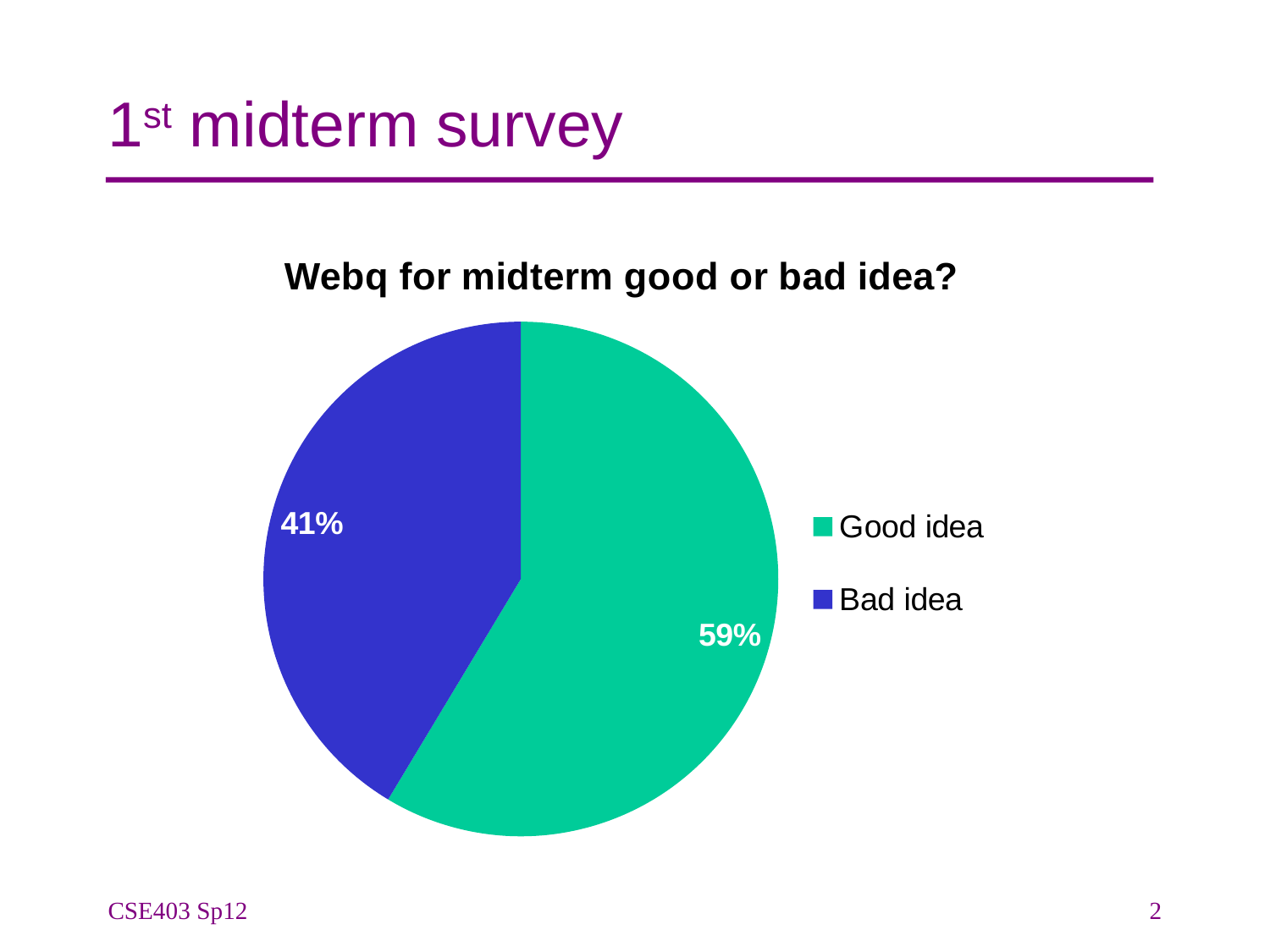
How many slices does the pie chart have? 2 What share of the pie is labelled "Bad idea"? 41% Which slice of the pie is the largest? Good idea What kind of chart is shown on the slide? pie chart How many entries does the legend list? 2 Which slice of the pie is the smallest? Bad idea What colour is the "Bad idea" slice? blue What is the title of the chart? Webq for midterm good or bad idea? Is the share for "Good idea" greater or less than 50%? greater What is the difference in percentage points between the "Good idea" and "Bad idea" slices? 18 percentage points Which is larger, the "Good idea" slice or the "Bad idea" slice? Good idea What share of the pie is labelled "Good idea"? 59%